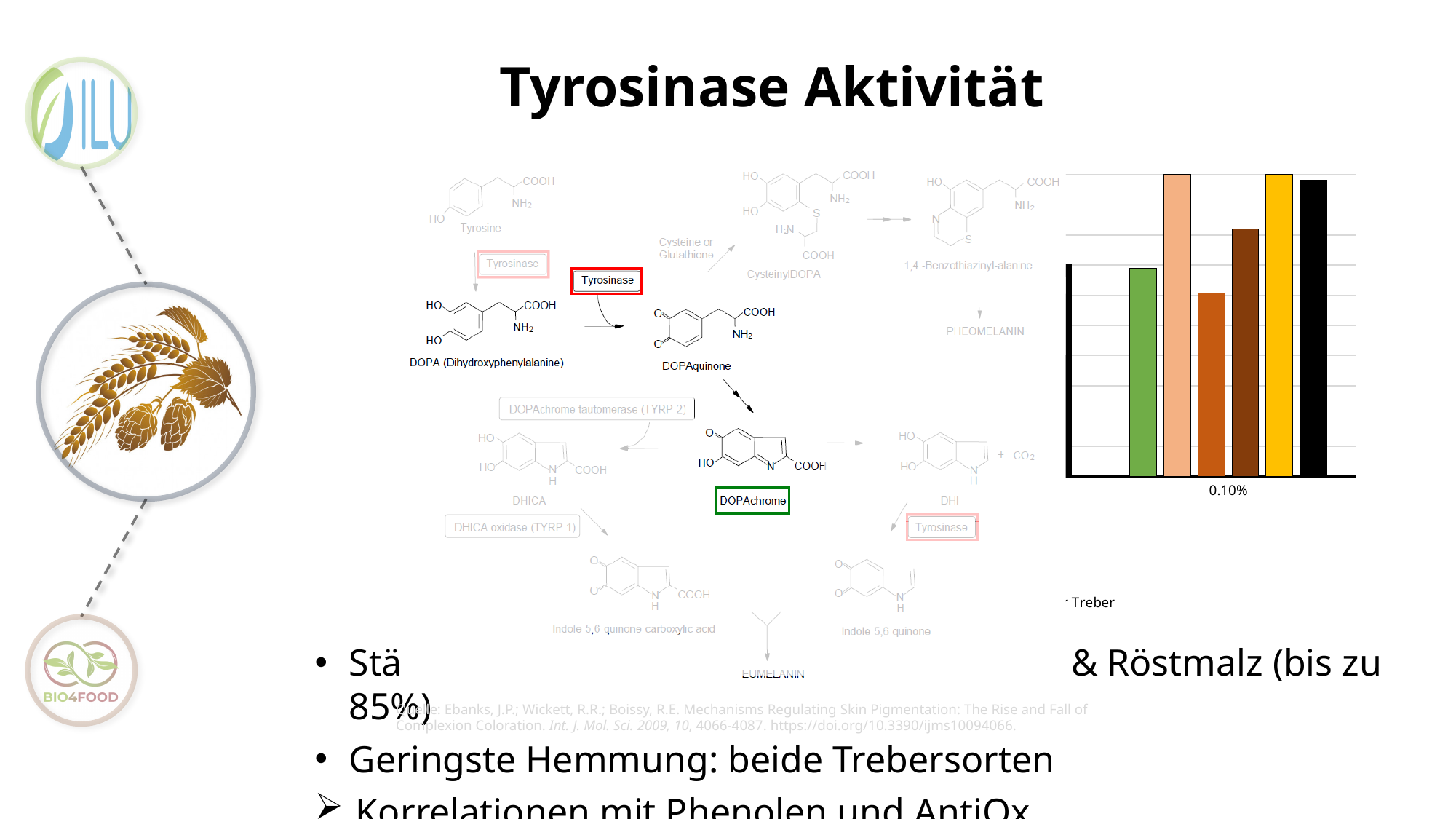
What kind of chart is shown on the right side of the slide? bar chart In the bar chart on the right side of the slide, is the brown bar or the green bar taller? the brown bar What category label is printed below the bars in the bar chart on the right side of the slide? 0.10% How many bars are plotted in the bar chart on the right side of the slide? 6 What colour is the leftmost bar in the bar chart on the right side of the slide? green In the bar chart on the right side of the slide, is the green bar or the orange bar taller? the green bar In the bar chart on the right side of the slide, which bar is the lowest? the orange bar (third from left) In the bar chart on the right side of the slide, is the yellow bar or the orange bar taller? the yellow bar